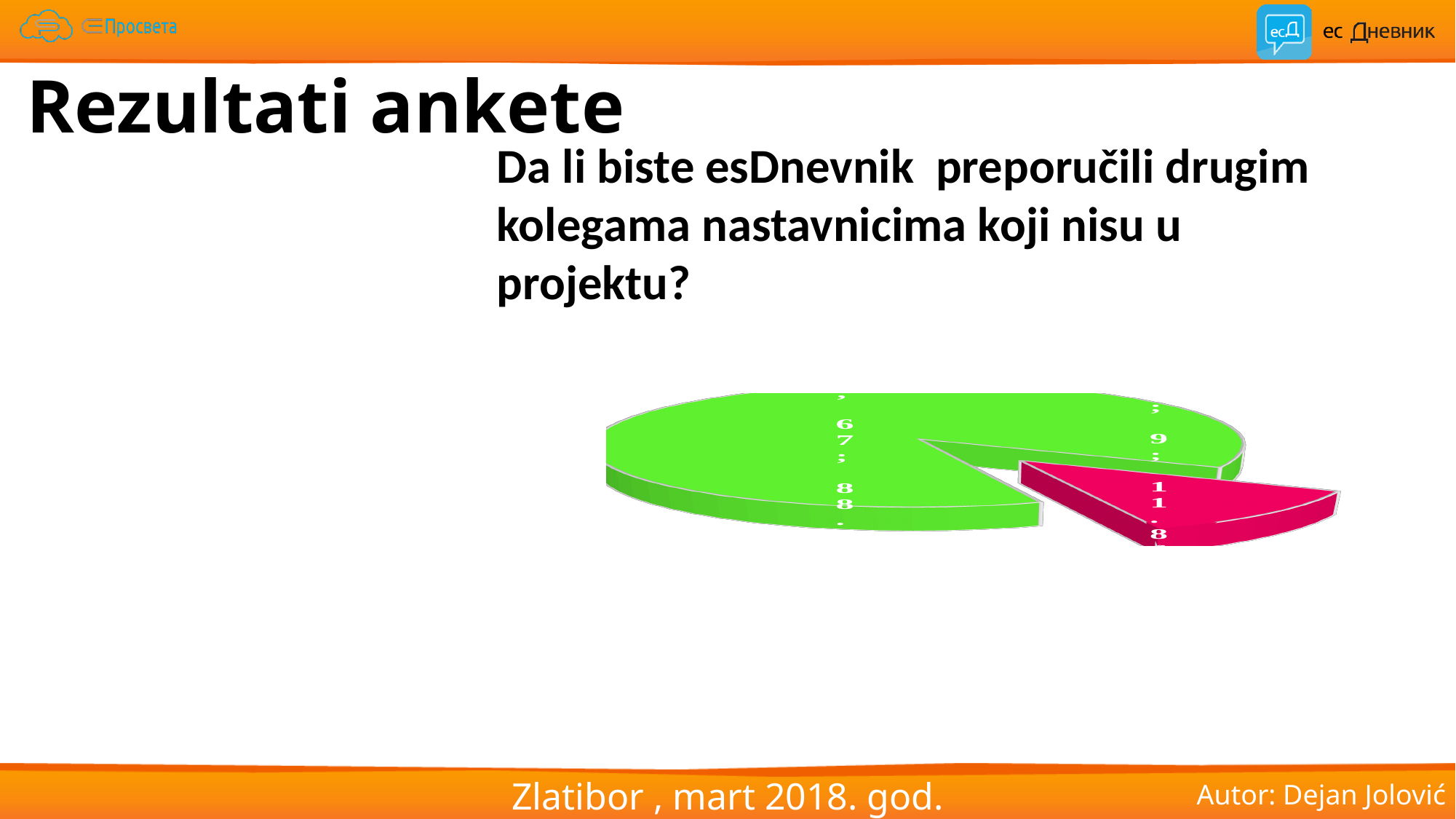
What is the difference between the counts printed on the green and pink slices? 58 How many slices does the pie chart have? 2 What kind of chart is shown on the slide? pie chart What count is printed on the green slice of the pie chart? 67 What count is printed on the pink slice of the pie chart? 9 Which slice of the pie chart is larger, the green one or the pink one? the green one What percentage is printed on the pink slice of the pie chart? 11.8 Which colour slice represents the smallest share of the pie chart? pink What two colours are used for the slices of the pie chart? green and pink What survey question does the pie chart on the slide answer? Da li biste esDnevnik preporučili drugim kolegama nastavnicima koji nisu u projektu? Which colour slice represents the largest share of the pie chart? green